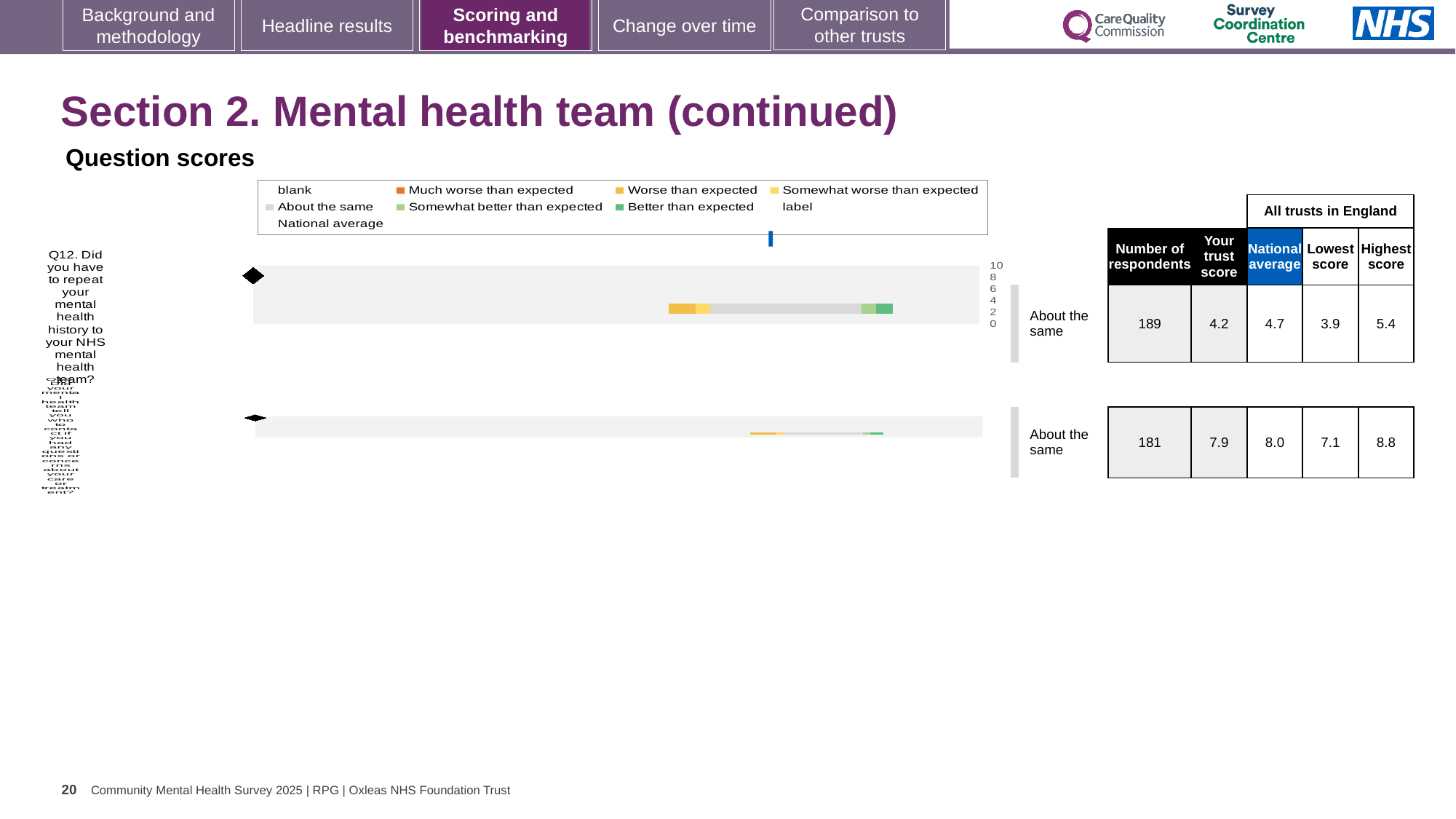
How many respondents answered Q12? 189 For Q12 (repeating mental health history), what is the trust's score shown in the table? 4.2 What benchmark category is shown next to the Q12 chart? About the same For the second (lower) question chart, what is the trust's score? 7.9 What kind of chart is used to show the question scores on this slide? bar chart For the second (lower) question chart, what is the difference between the highest score (8.8) and the lowest score (7.1)? 1.7 For Q12, what is the difference between the highest and lowest scores among all trusts in England? 1.5 For Q12, what is the national average score? 4.7 For the second (lower) question chart, how many respondents are there? 181 Which question has more respondents: Q12 or the second (lower) question? Q12 For Q12, what is the highest score among all trusts in England? 5.4 For Q12, which is larger: the trust's score or the national average? National average